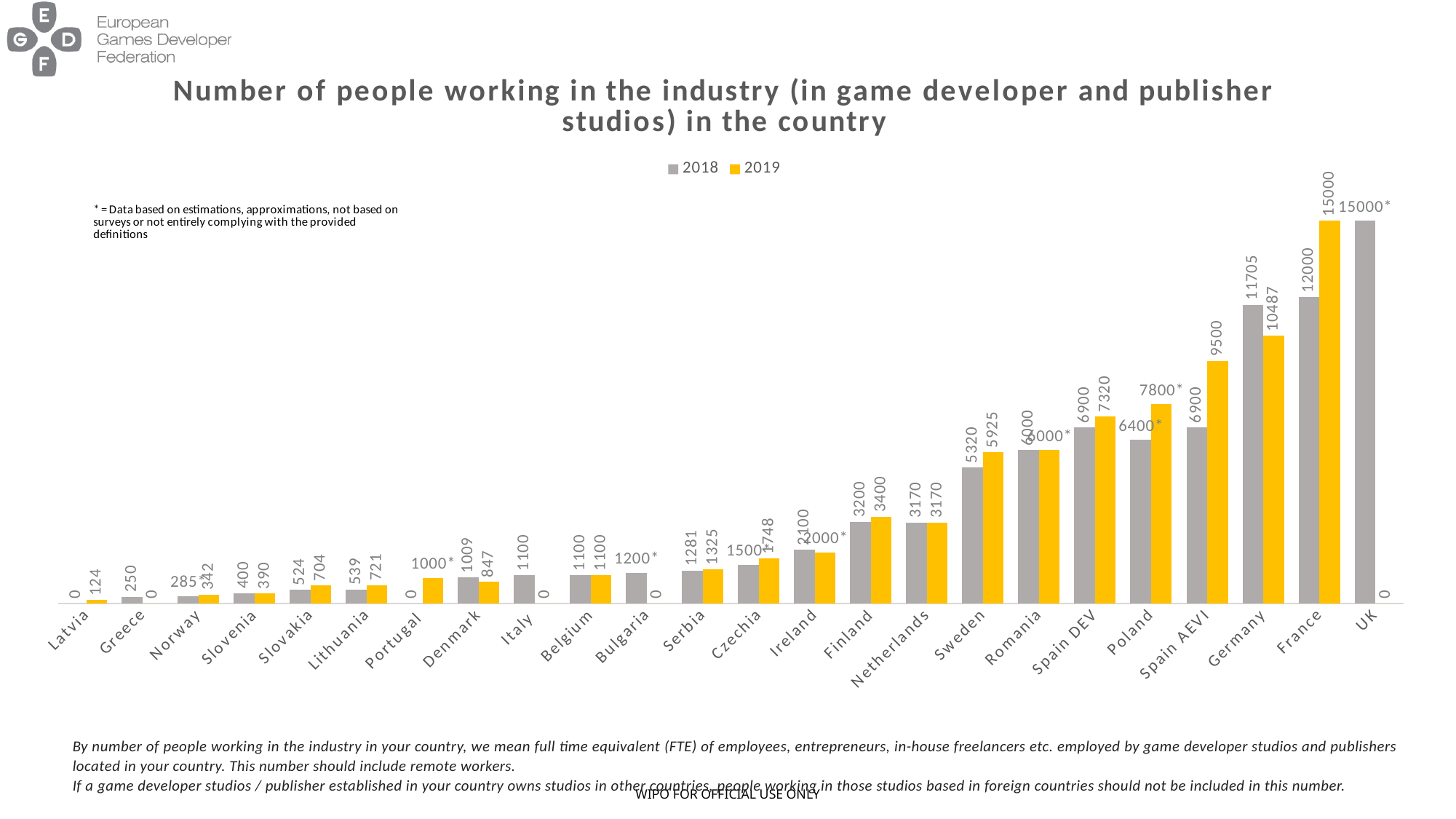
Which series is shown in yellow? 2019 What is the 2019 value for Spain AEVI? 9500 How many series does the legend list? 2 Which is larger, the 2019 value for Poland or the 2019 value for Spain DEV? Poland What is the 2019 value for France? 15000 What is the 2018 value for Sweden? 5320 What is the difference between the 2019 and 2018 values for Spain AEVI? 2600 Which country has the highest 2019 value? France What kind of chart is shown on the slide? bar chart How many countries are shown on the x axis? 24 What is the 2018 value for Germany? 11705 What is the difference between the 2018 and 2019 values for Germany? 1218